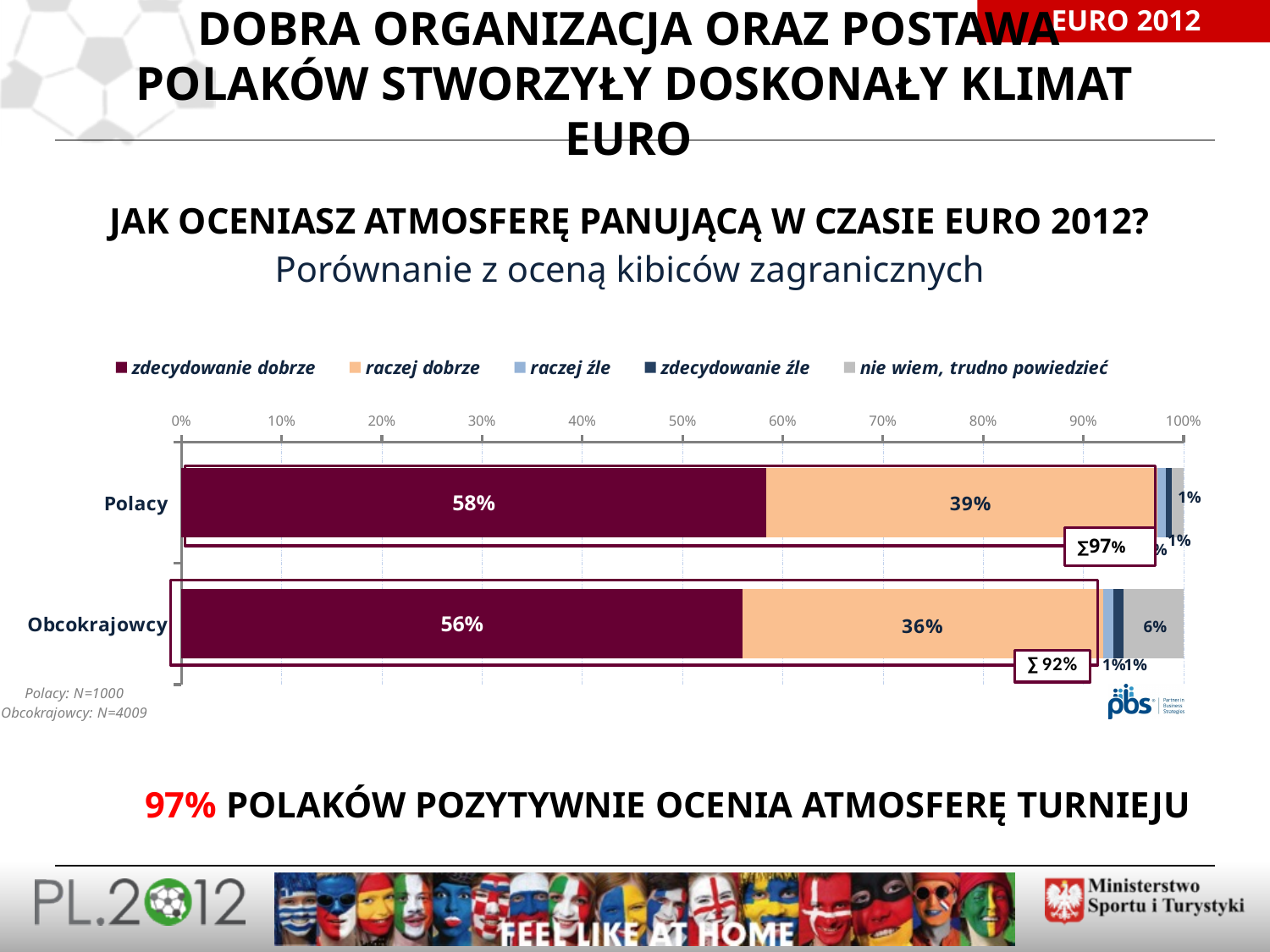
Which category has the larger 'raczej dobrze' value, Polacy or Obcokrajowcy? Polacy How many categories are plotted on the chart? 2 What is the value of 'raczej dobrze' for Obcokrajowcy? 36% What kind of chart is shown on the slide? bar chart What is the combined positive share (∑) shown for Polacy? 97% How many series does the legend list? 5 What is the difference between the 'zdecydowanie dobrze' values for Polacy and Obcokrajowcy? 2% What is the value of 'zdecydowanie dobrze' for Obcokrajowcy? 56% Which legend entry is shown in the darkest (maroon) colour? zdecydowanie dobrze What is the combined positive share (∑) shown for Obcokrajowcy? 92% What is the value of 'zdecydowanie dobrze' for Polacy? 58% What is the value of 'nie wiem, trudno powiedzieć' for Obcokrajowcy? 6%